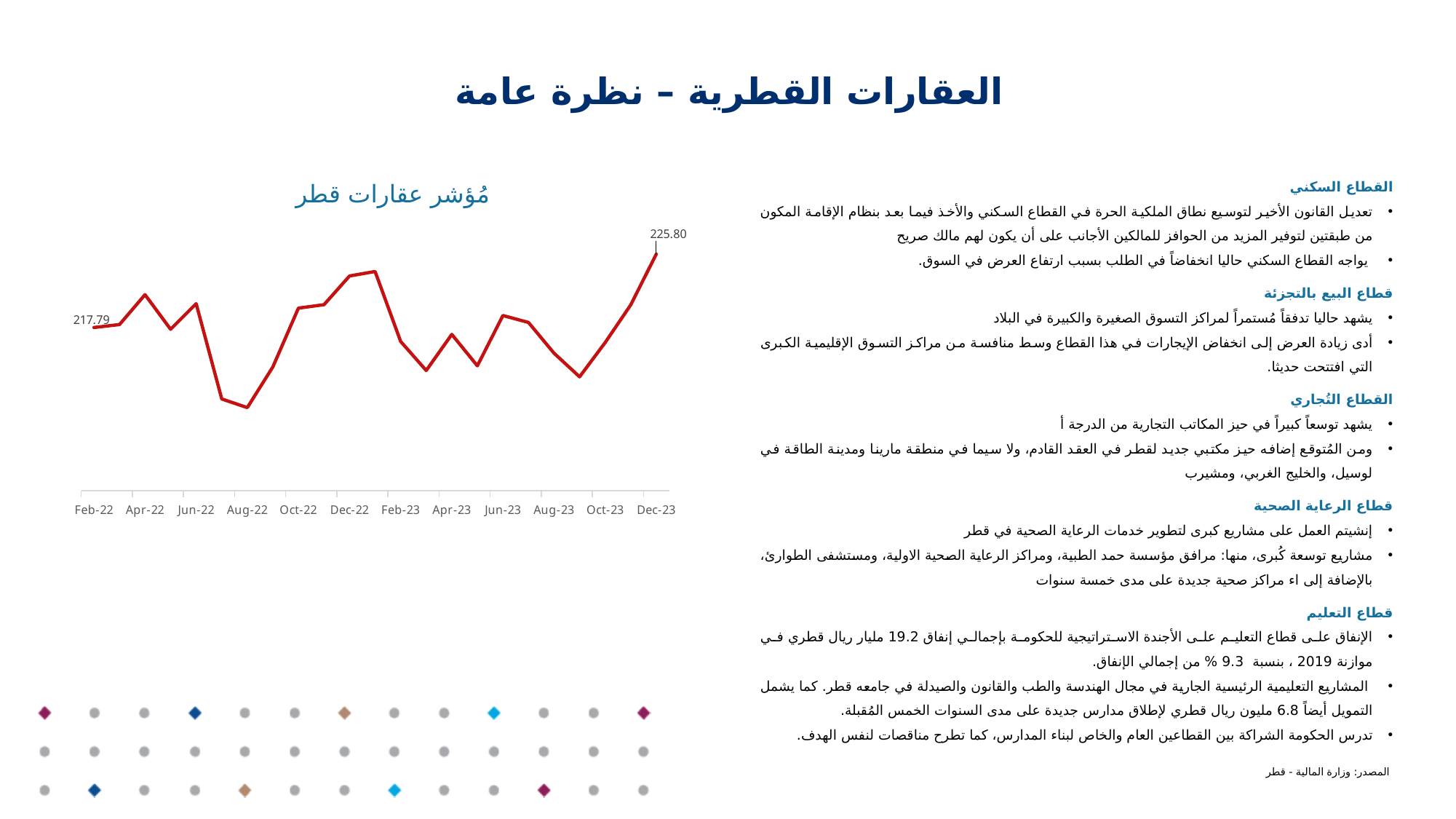
What type of chart is shown on the slide? line chart Which is larger, the index value at Feb-22 or at Dec-23? Dec-23 What is the title of the chart? مُؤشر عقارات قطر Comparing the first and last points, does the index rise or fall over the period shown? rise At which month does the line reach its highest point? Dec-23 What colour is the line on the chart? red How many month labels are shown on the x axis? 12 What is the value of the index at Feb-22, the first point on the chart? 217.79 How many data series are plotted on the chart? 1 What is the difference between the index value at Dec-23 and at Feb-22? 8.01 At which month does the line reach its lowest point? Aug-22 What is the value of the index at Dec-23, the last point on the chart? 225.80